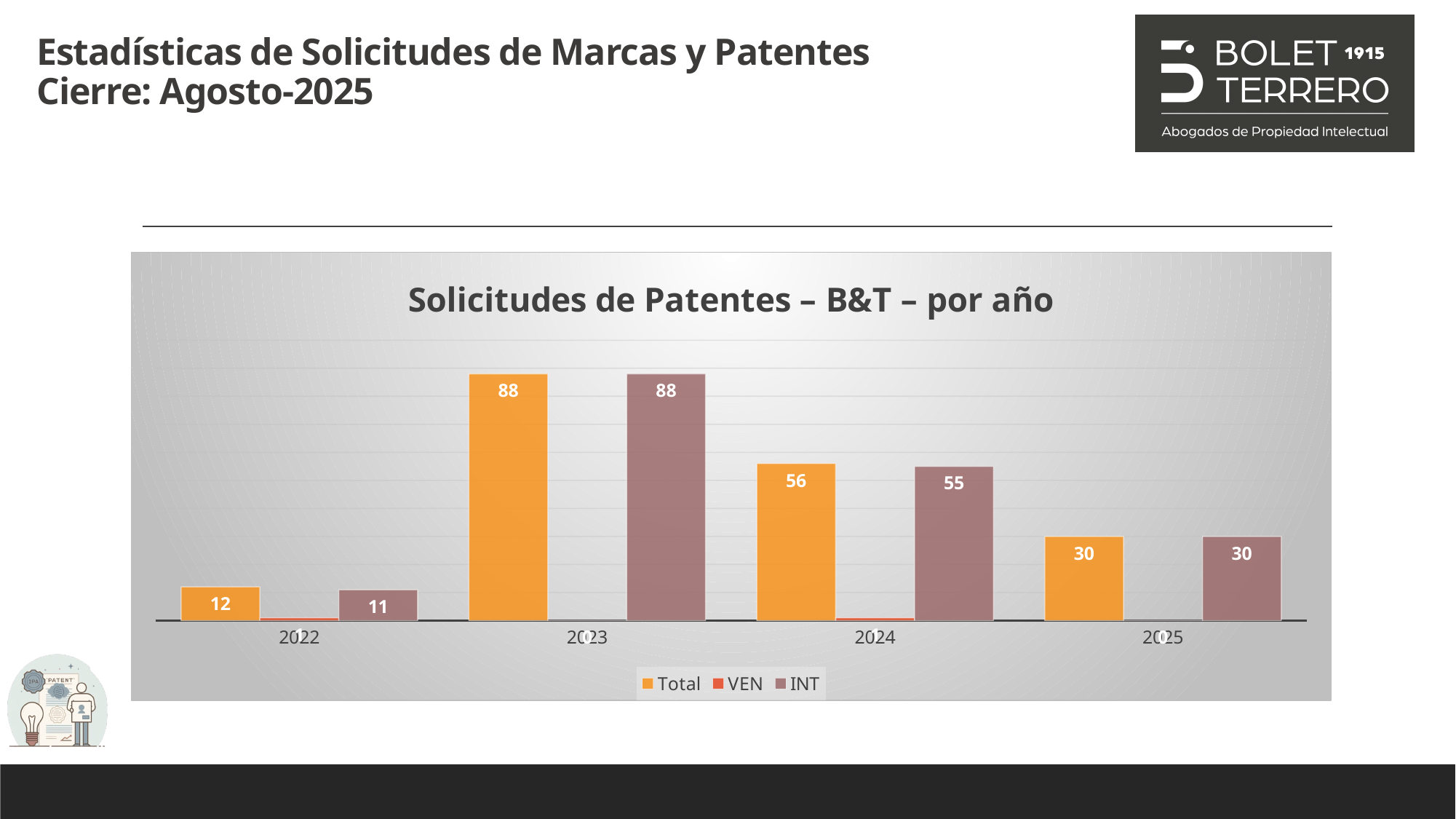
Which is larger in 2022, the Total value or the INT value? Total What is the INT value for 2025? 30 What is the Total value for 2023? 88 Do the Total values rise or fall from 2023 to 2025? Fall How many series does the legend list? 3 Which year has the lowest Total value? 2022 What kind of chart is shown on the slide? Bar chart What is the difference between the Total values for 2023 and 2024? 32 What is the INT value for 2024? 55 What is the Total value for 2022? 12 How many years are shown on the x axis? 4 Which year has the highest Total value? 2023